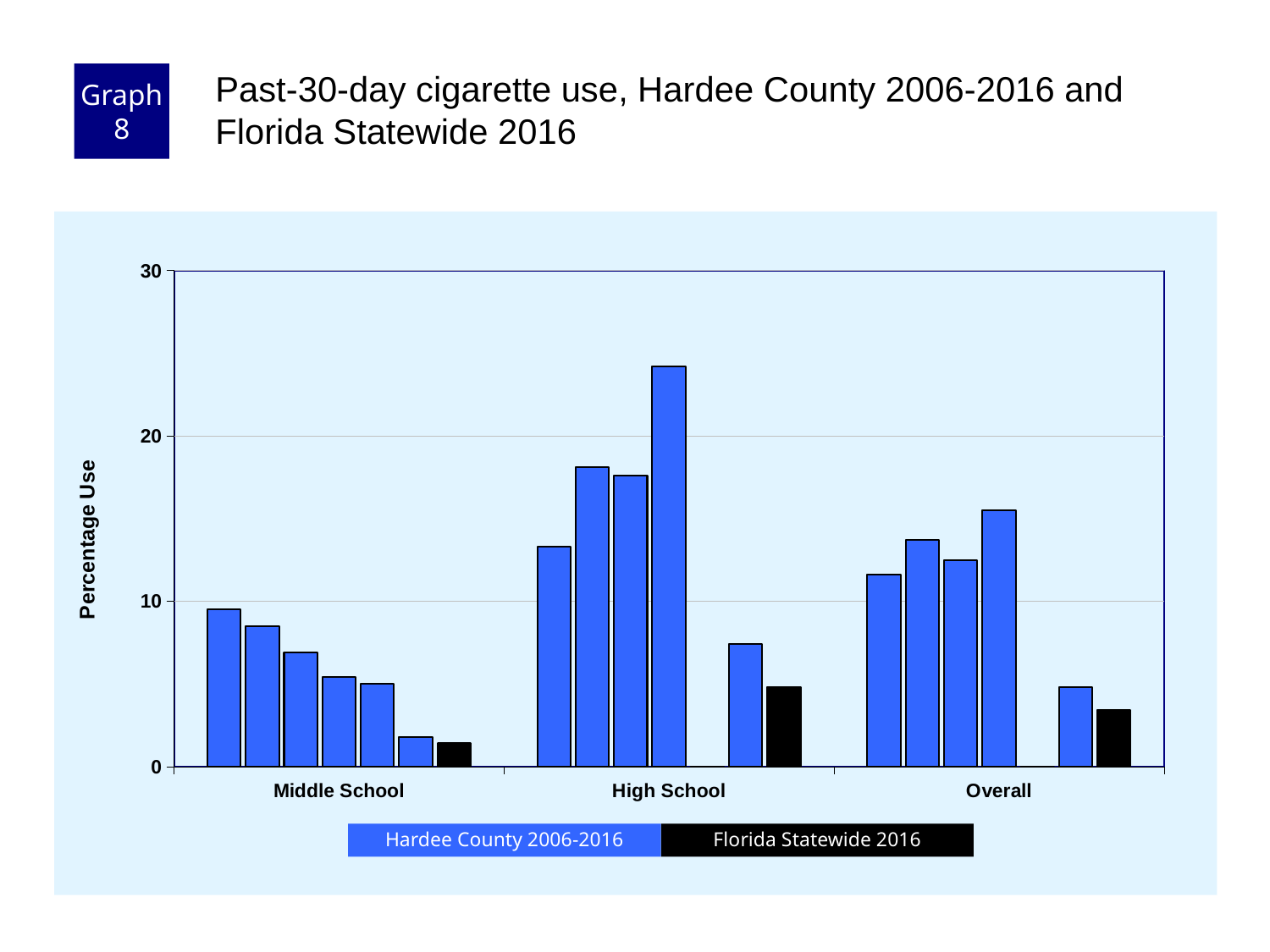
Which series is shown in black in the legend? Florida Statewide 2016 What kind of chart is shown on the slide? bar chart Is the tallest bar in the Overall group greater or less than 10? greater Is the Florida Statewide 2016 bar for Middle School greater or less than 10? less Is the tallest bar in the Overall group greater or less than 20? less Which category group contains the tallest bar on the chart? High School Which category group has the lowest Florida Statewide 2016 bar? Middle School How many category groups are shown on the x axis? 3 How many series does the legend list? 2 Do the Hardee County 2006-2016 bars in the Middle School group rise or fall from left to right? fall What is the label on the y axis? Percentage Use